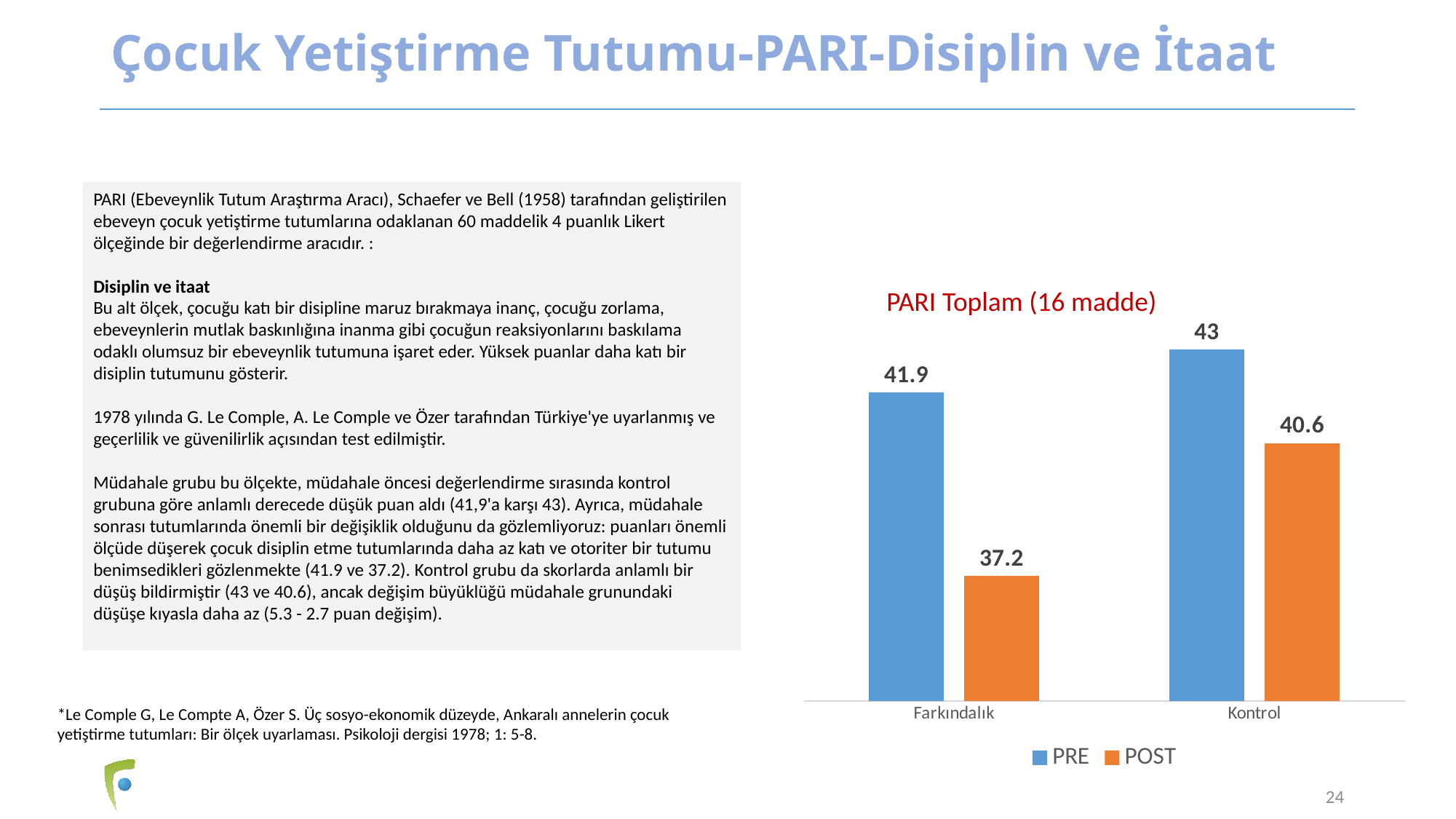
What is the difference between the PRE and POST values for Kontrol? 2.4 What is the POST value for Kontrol? 40.6 What is the PRE value for Farkındalık? 41.9 How many series does the legend list? 2 Which is larger, the POST value for Farkındalık or the POST value for Kontrol? Kontrol What is the PRE value for Kontrol? 43 How many categories are shown on the x axis? 2 What is the difference between the PRE and POST values for Farkındalık? 4.7 Which group has the highest PRE value? Kontrol What is the POST value for Farkındalık? 37.2 Which bar shows the lowest value in the chart? Farkındalık POST What type of chart is shown on the slide? Bar chart